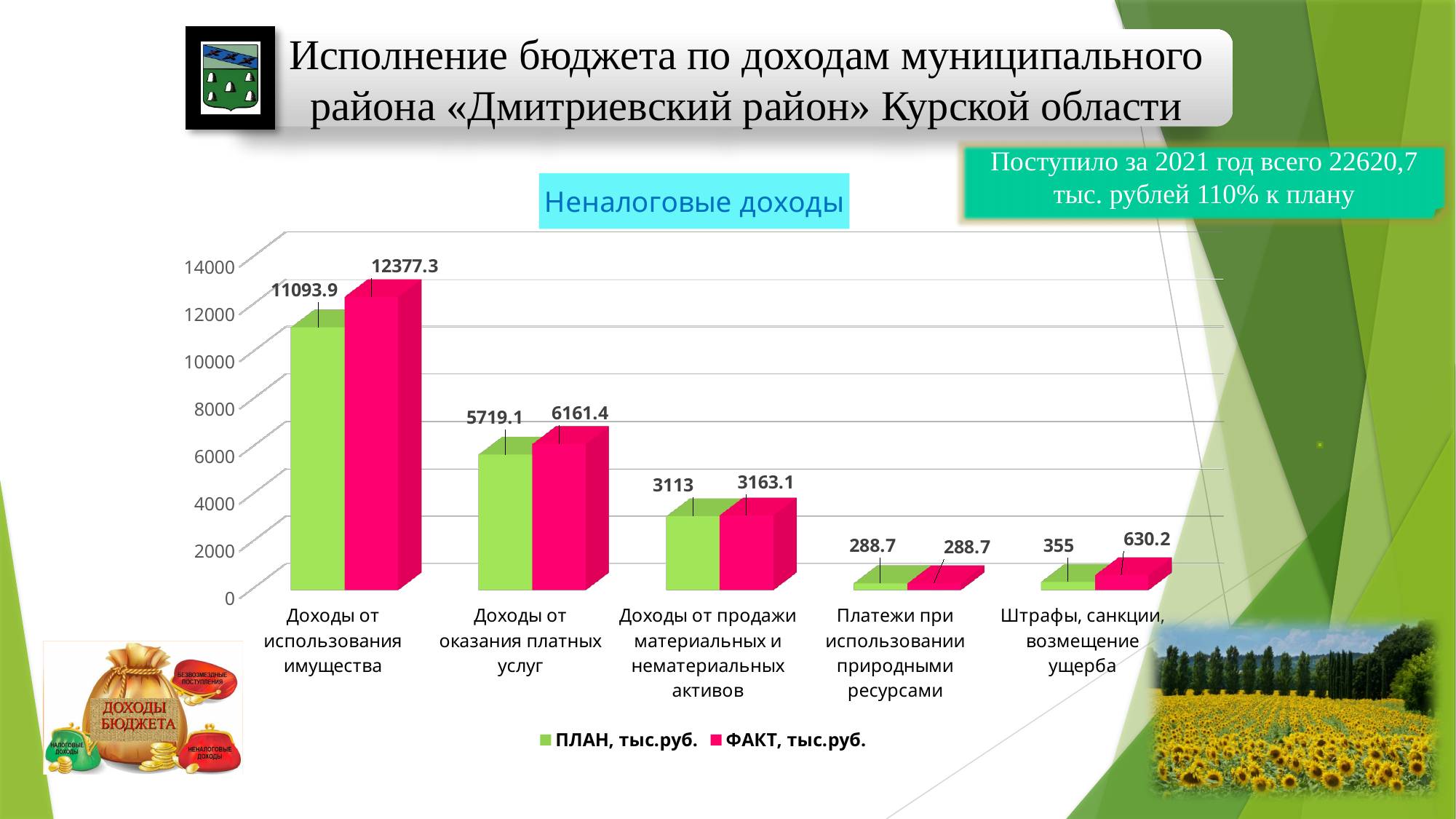
What is the difference between the ФАКТ and ПЛАН values for «Доходы от использования имущества»? 1283.4 Which is larger for «Доходы от оказания платных услуг»: the ПЛАН value or the ФАКТ value? ФАКТ Which category has the lowest ПЛАН value? Платежи при использовании природными ресурсами What is the difference between the ФАКТ and ПЛАН values for «Штрафы, санкции, возмещение ущерба»? 275.2 How many series does the legend list? 2 What is the title of the chart? Неналоговые доходы What is the ФАКТ value for «Доходы от использования имущества»? 12377.3 What is the ПЛАН value for «Доходы от оказания платных услуг»? 5719.1 How many categories are shown on the x axis of the chart? 5 What is the ПЛАН value for «Штрафы, санкции, возмещение ущерба»? 355 Which category has the highest ФАКТ value? Доходы от использования имущества What kind of chart is shown on the slide? Bar chart